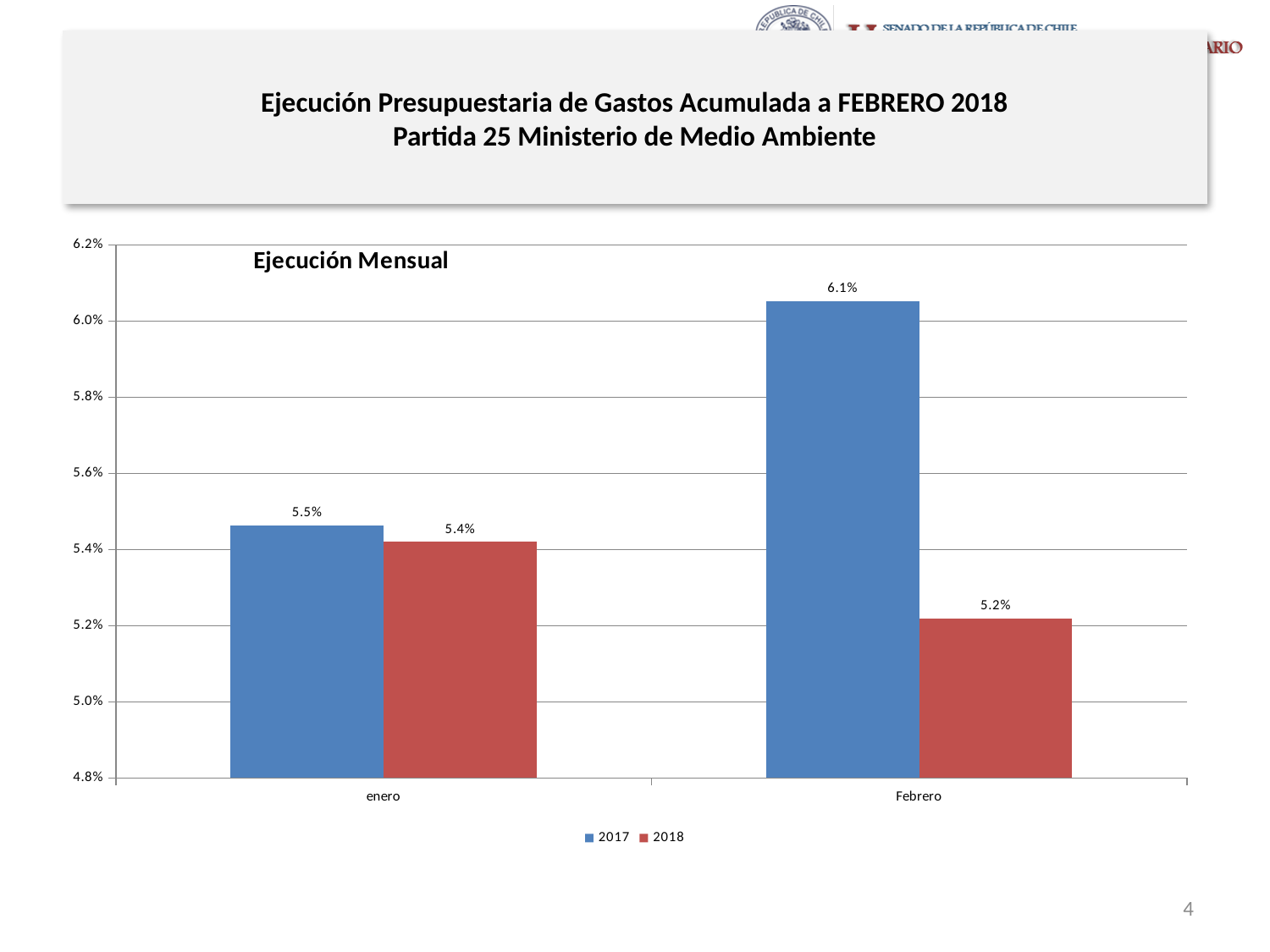
Is the value for 2017 in Febrero greater or less than 6.0%? greater How many series does the legend list? 2 What is the difference between the 2017 and 2018 values in Febrero? 0.9% Which month has the highest value for the 2017 series? Febrero What kind of chart is shown? bar chart Which is larger in enero, the 2017 value or the 2018 value? 2017 What is the value for 2017 in enero? 5.5% Which month has the lowest value for the 2018 series? Febrero What is the value for 2018 in Febrero? 5.2% What is the value for 2017 in Febrero? 6.1% How many months are shown on the x axis? 2 What is the value for 2018 in enero? 5.4%